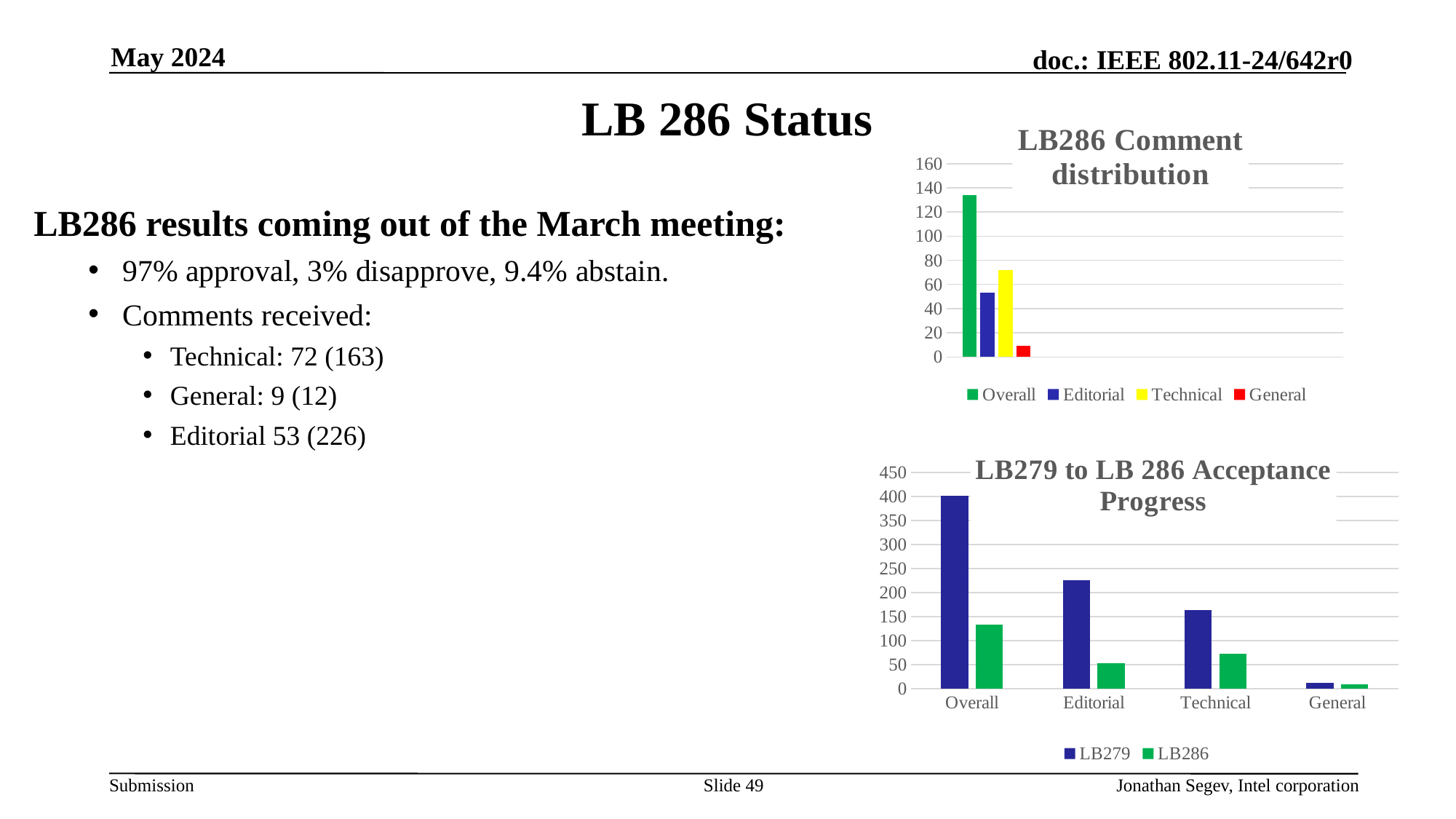
In the 'LB279 to LB 286 Acceptance Progress' chart, how many series does the legend list? 2 In the 'LB286 Comment distribution' chart, is the value for Overall greater or less than 120? greater In the 'LB279 to LB 286 Acceptance Progress' chart, is the LB279 value for Overall greater or less than 350? greater In the 'LB286 Comment distribution' chart, how many entries does the legend list? 4 In the 'LB279 to LB 286 Acceptance Progress' chart, is the LB279 value for Technical greater or less than 200? less In the 'LB279 to LB 286 Acceptance Progress' chart, which category has the highest LB279 value? Overall In the 'LB286 Comment distribution' chart, which is larger, Technical or Editorial? Technical In the 'LB286 Comment distribution' chart, which category has the highest value? Overall In the 'LB279 to LB 286 Acceptance Progress' chart, how many categories are shown on the x axis? 4 In the 'LB286 Comment distribution' chart, which category has the lowest value? General In the 'LB286 Comment distribution' chart, what kind of chart is shown? bar chart In the 'LB279 to LB 286 Acceptance Progress' chart, for Editorial, which series has the larger value, LB279 or LB286? LB279